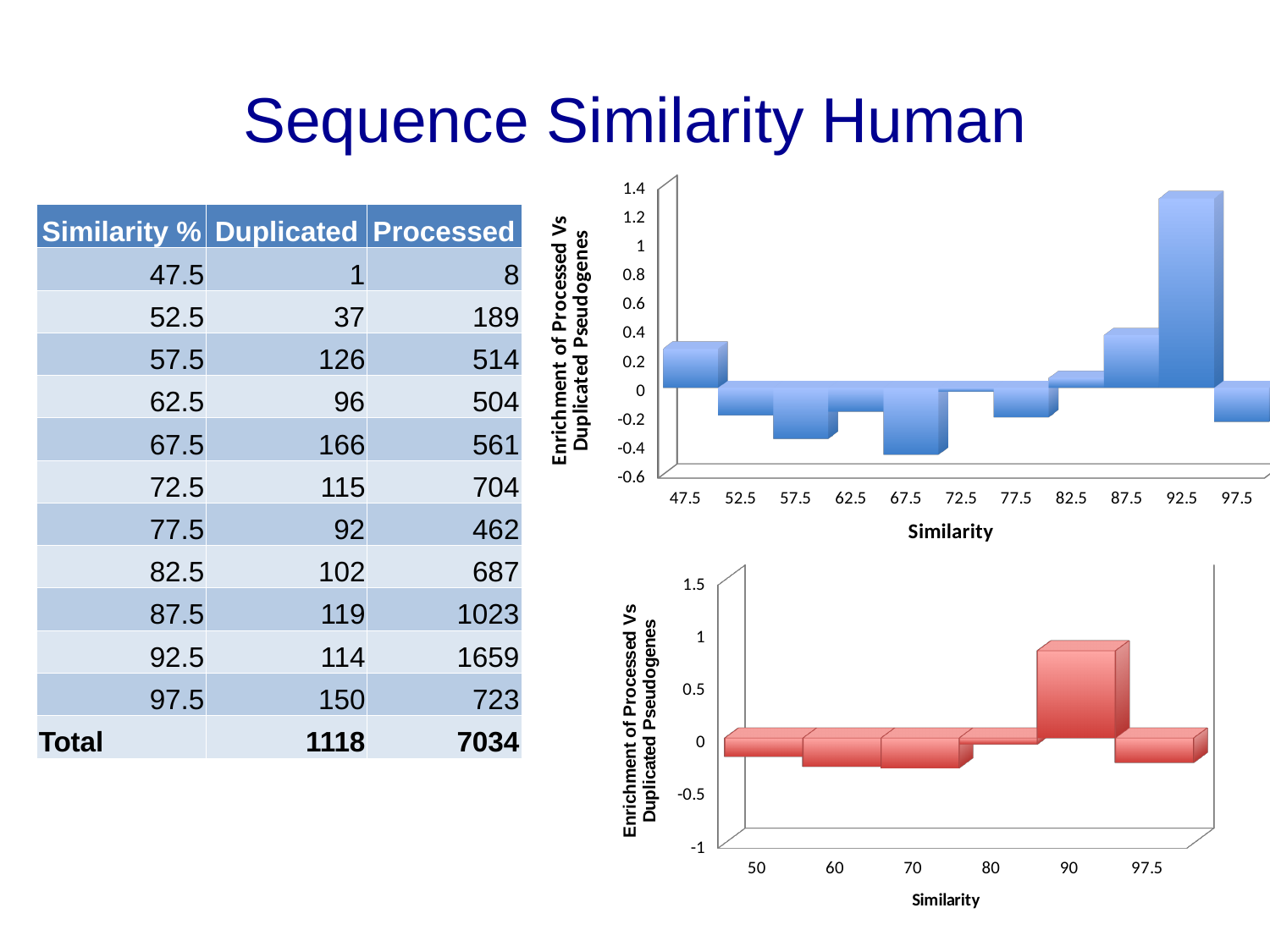
In the bottom chart, how many similarity categories are shown on the x axis? 6 In the top chart, which similarity category has the highest enrichment value? 92.5 In the top chart, which similarity category has the lowest enrichment value? 67.5 What kind of chart is the top chart on the slide? bar chart What is the x-axis title of the top chart? Similarity In the top chart, which has the larger value, 47.5 or 57.5? 47.5 In the bottom chart, which similarity category has the highest enrichment value? 90 In the top chart, is the value for 92.5 greater or less than 1? greater In the top chart, is the value for 67.5 greater or less than -0.2? less In the bottom chart, is the value for 90 greater or less than 0.5? greater In the top chart, how many similarity categories are shown on the x axis? 11 What kind of chart is the bottom chart on the slide? bar chart